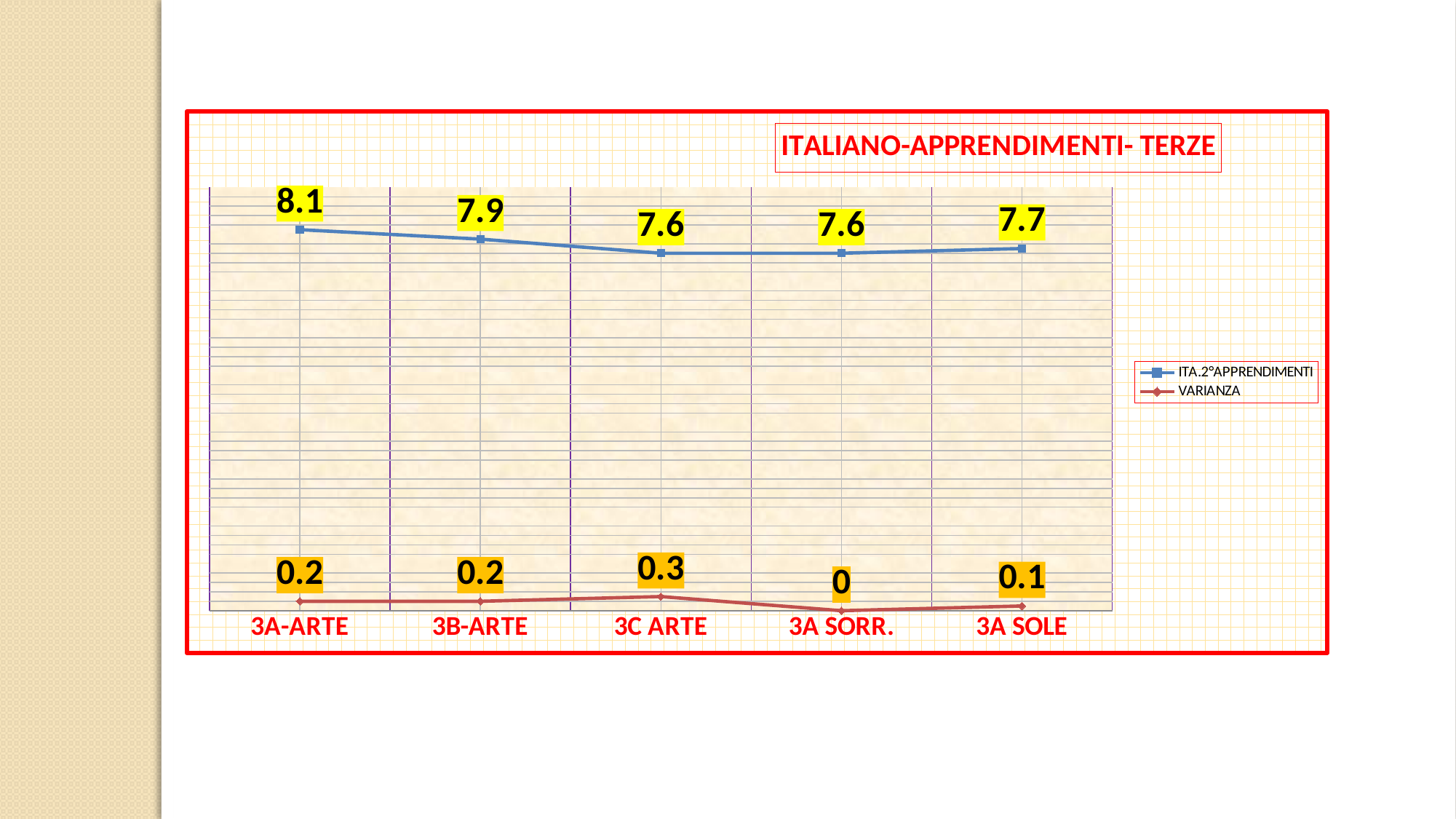
What is the VARIANZA value for 3A SORR.? 0 What is the difference between the ITA.2°APPRENDIMENTI values for 3A-ARTE and 3C ARTE? 0.5 Which is larger, the ITA.2°APPRENDIMENTI value for 3B-ARTE or for 3A SOLE? 3B-ARTE What is the ITA.2°APPRENDIMENTI value for 3A-ARTE? 8.1 What is the VARIANZA value for 3C ARTE? 0.3 How many series does the legend list? 2 Which category has the highest ITA.2°APPRENDIMENTI value? 3A-ARTE What is the title of the chart? ITALIANO-APPRENDIMENTI- TERZE What is the ITA.2°APPRENDIMENTI value for 3A SOLE? 7.7 How many categories are shown on the x axis? 5 What kind of chart is shown on the slide? line chart Which category has the lowest VARIANZA value? 3A SORR.